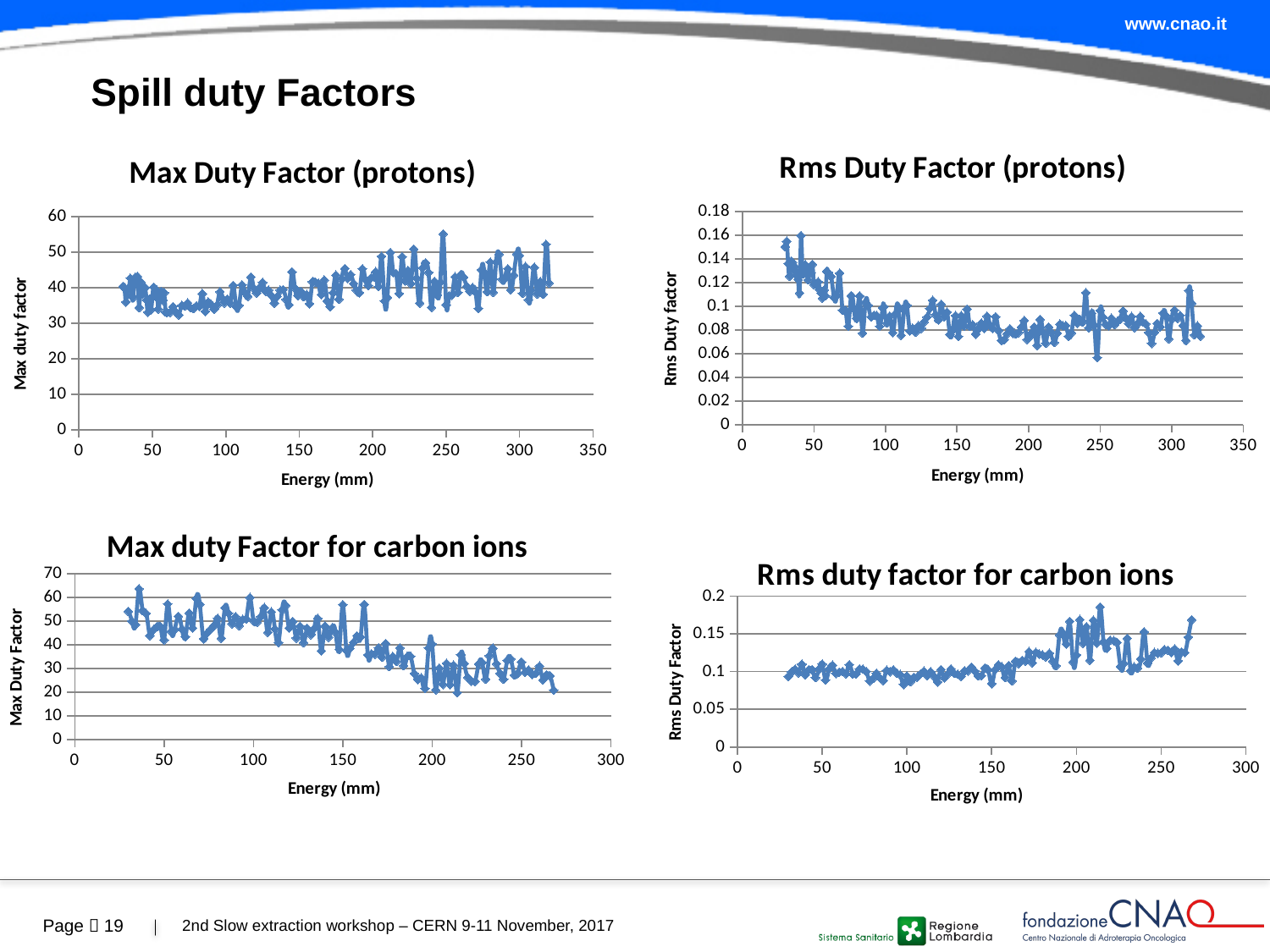
How many charts are shown on the slide? 4 In the 'Max duty Factor for carbon ions' chart, do the values rise or fall as energy increases along the x axis? fall In the 'Rms Duty Factor (protons)' chart, is the value at about 200 mm energy greater or less than 0.1? less In the 'Max duty Factor for carbon ions' chart, is the value at about 270 mm energy greater or less than 30? less In the 'Rms duty factor for carbon ions' chart, is the value at about 50 mm energy greater or less than 0.15? less What is the y-axis title of the 'Rms Duty Factor (protons)' chart? Rms Duty factor In the 'Max duty Factor for carbon ions' chart, which is larger: the value at about 50 mm energy or the value at about 250 mm energy? 50 mm In the 'Rms Duty Factor (protons)' chart, do the values rise or fall as energy increases along the x axis? fall In the 'Rms duty factor for carbon ions' chart, do the values rise or fall as energy increases along the x axis? rise What is the x-axis title of the 'Max Duty Factor (protons)' chart? Energy (mm) What kind of chart is 'Max Duty Factor (protons)'? scatter chart